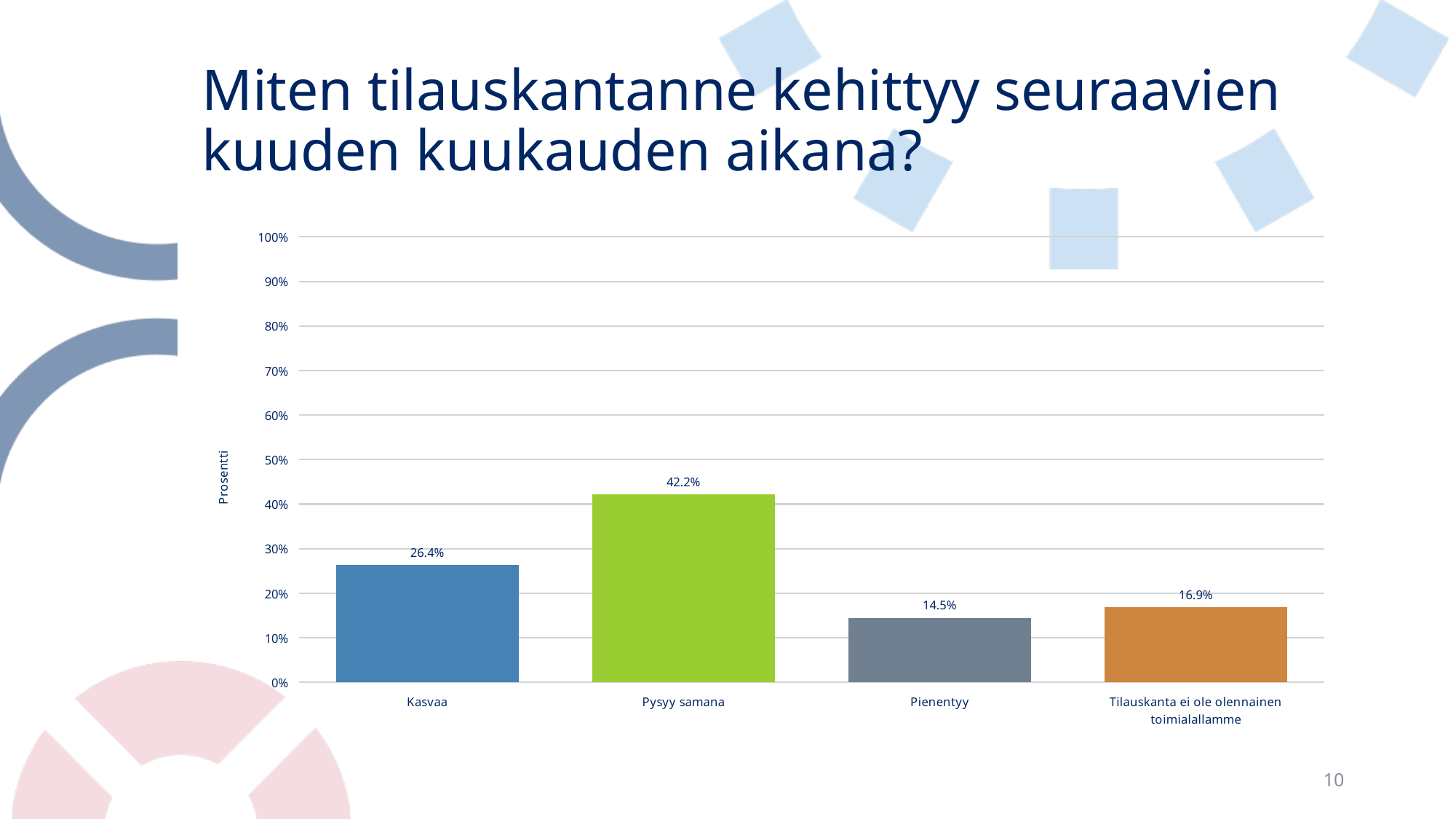
What is the value for Pienentyy? 14.5% How many categories are shown on the x axis? 4 Which is larger, the value for Kasvaa or the value for Pienentyy? Kasvaa What is the label of the vertical axis? Prosentti What is the value for Tilauskanta ei ole olennainen toimialallamme? 16.9% What kind of chart is shown on the slide? bar chart Is the value for Pysyy samana greater or less than 40%? greater What is the value for Kasvaa? 26.4% Which category has the lowest value? Pienentyy What is the value for Pysyy samana? 42.2% Which category has the highest value? Pysyy samana What is the difference between the values for Pysyy samana and Kasvaa? 15.8%